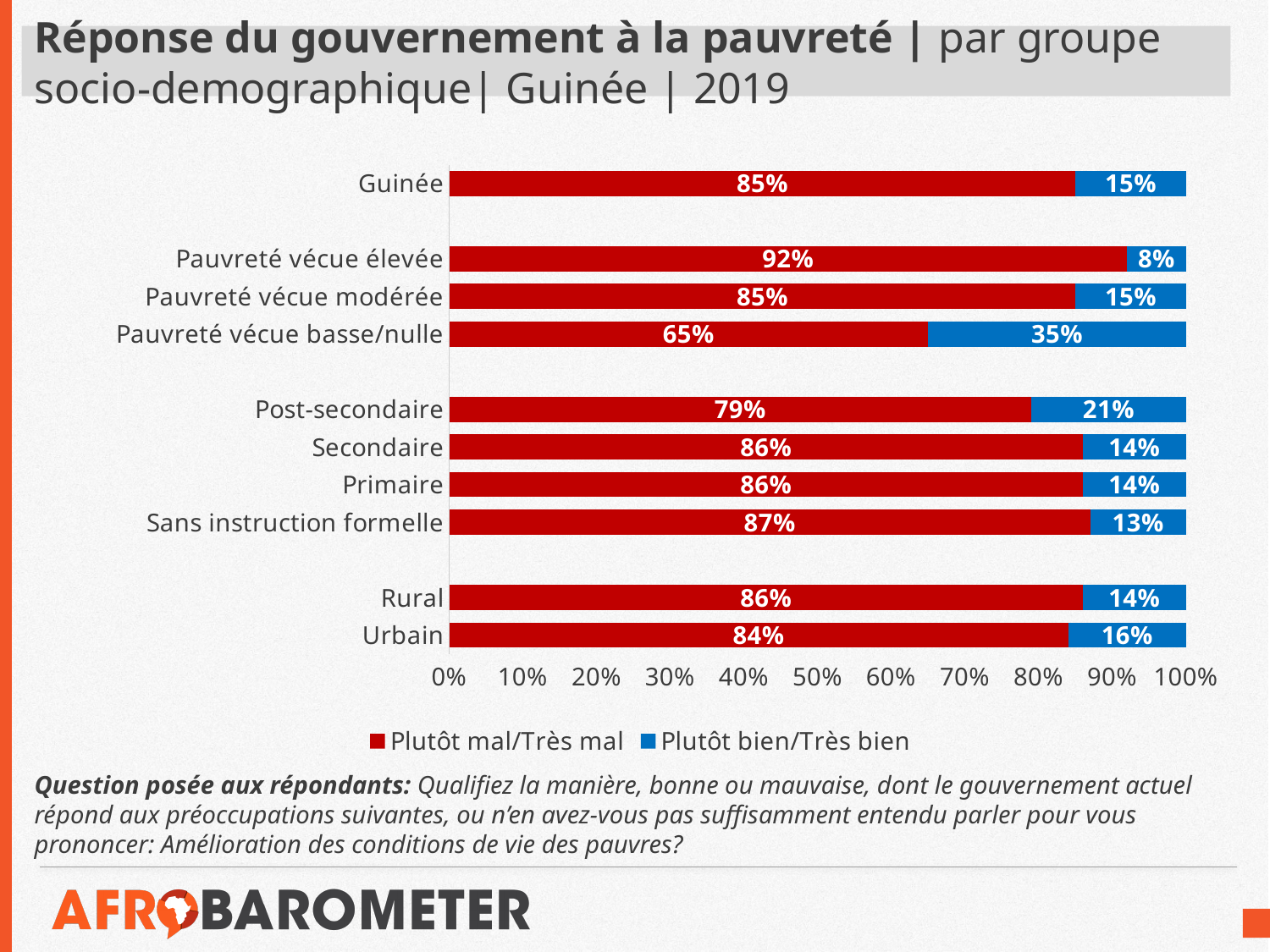
What is the difference between the 'Plutôt mal/Très mal' values for Pauvreté vécue élevée and Pauvreté vécue basse/nulle? 27 percentage points Which category has the lowest value for 'Plutôt bien/Très bien'? Pauvreté vécue élevée Is the 'Plutôt mal/Très mal' value for Sans instruction formelle greater or less than 80%? greater How many categories are shown on the chart? 10 What is the value for 'Plutôt bien/Très bien' for Pauvreté vécue basse/nulle? 35% Which is larger: the 'Plutôt bien/Très bien' value for Rural or for Urbain? Urbain What kind of chart is shown on the slide? Stacked bar chart What is the value for 'Plutôt mal/Très mal' for Guinée? 85% How many series does the legend list? 2 What is the value for 'Plutôt mal/Très mal' for Post-secondaire? 79% What is the value for 'Plutôt bien/Très bien' for Urbain? 16% Which category has the highest value for 'Plutôt mal/Très mal'? Pauvreté vécue élevée